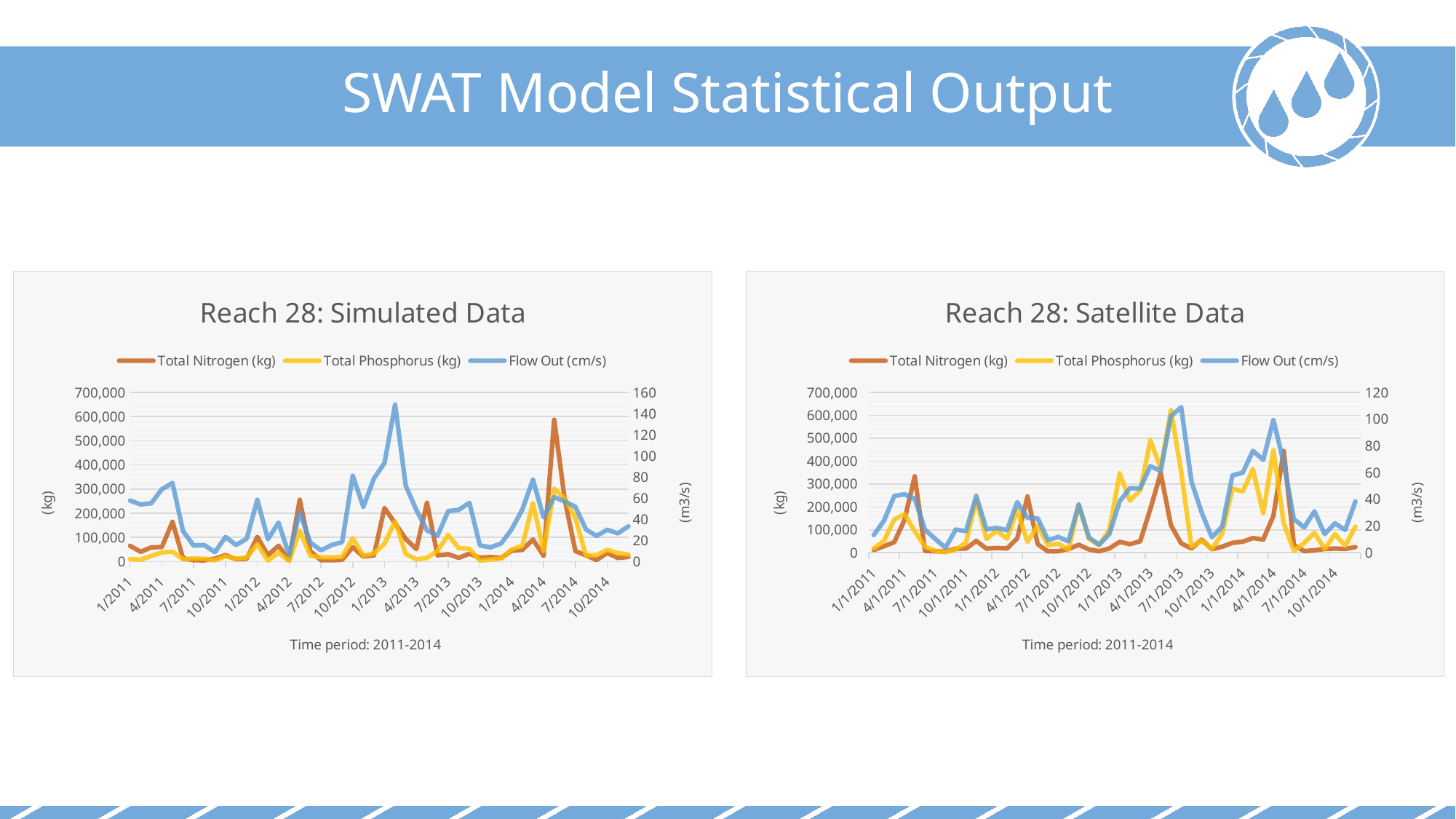
In 'Reach 28: Simulated Data', is the peak value of Total Nitrogen (kg) greater or less than 500,000? greater What is the maximum value shown on the right-hand (m3/s) axis of 'Reach 28: Simulated Data'? 160 What type of chart is 'Reach 28: Simulated Data'? line chart What is the maximum value shown on the right-hand (m3/s) axis of 'Reach 28: Satellite Data'? 120 In 'Reach 28: Satellite Data', is the peak value of Total Nitrogen (kg) greater or less than 600,000? less In 'Reach 28: Satellite Data', is the highest Flow Out (cm/s) value greater or less than 80? greater In 'Reach 28: Simulated Data', which series is plotted in blue? Flow Out (cm/s) How many series does the legend of 'Reach 28: Satellite Data' list? 3 What is the x-axis title of the 'Reach 28: Satellite Data' chart? Time period: 2011-2014